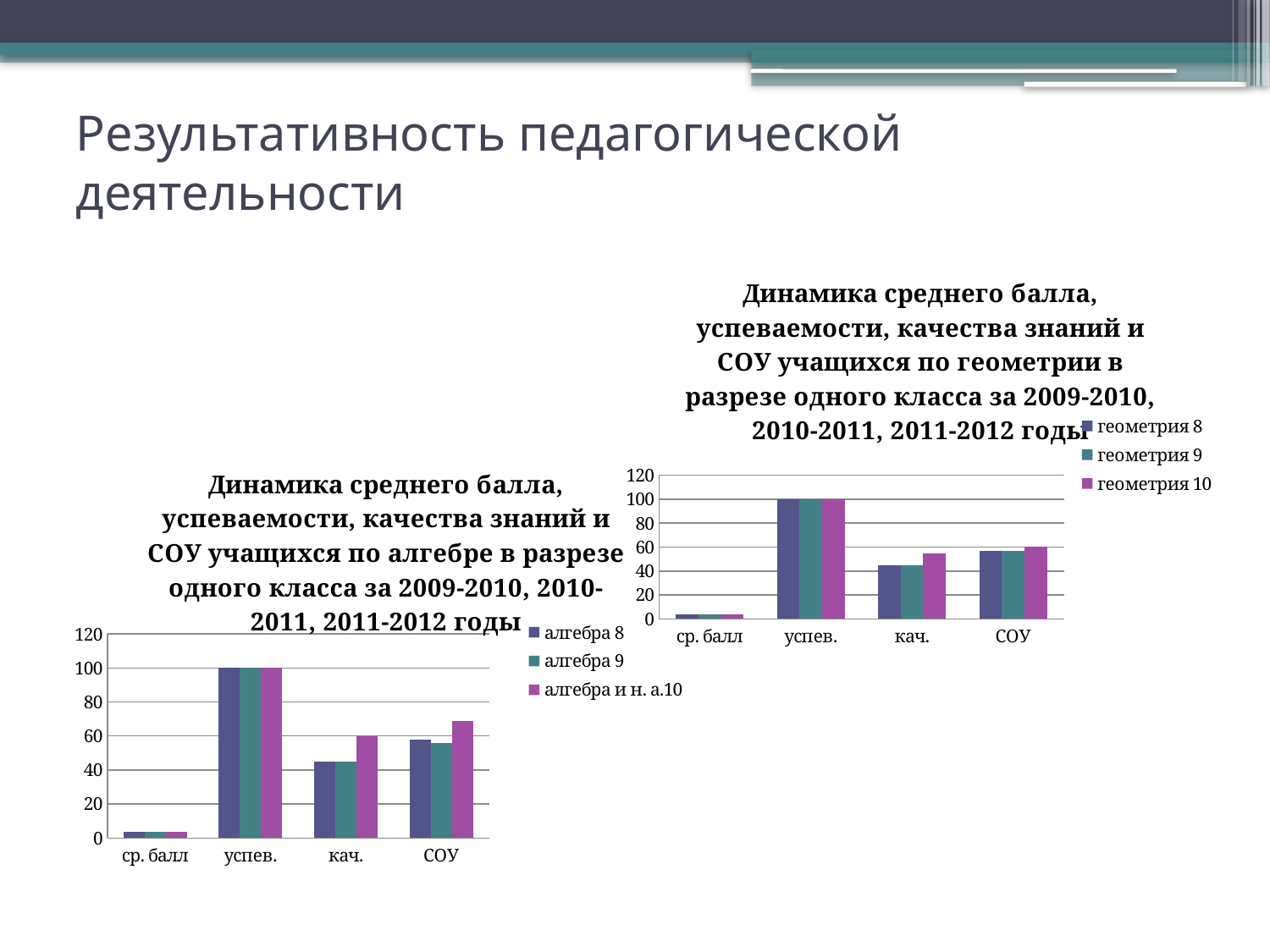
In the right chart about geometry, what is the value for успев. for the series геометрия 10? 100 How many series does the legend of the left chart about algebra list? 3 How many categories are shown on the x axis of the right chart about geometry? 4 In the right chart about geometry, which category has the lowest values? ср. балл In the left chart about algebra, which category has the highest values? успев. In the left chart about algebra, is the value for кач. for the series алгебра 8 greater or less than 60? less What kind of chart is the left chart about algebra? bar chart In the right chart about geometry, is the value for ср. балл for the series геометрия 9 greater or less than 20? less In the left chart about algebra, which is larger for кач.: the value for алгебра 8 or the value for алгебра и н. а.10? алгебра и н. а.10 What are the legend entries of the right chart about geometry? геометрия 8, геометрия 9, геометрия 10 In the left chart about algebra, is the value for СОУ for the series алгебра и н. а.10 greater or less than 60? greater In the left chart about algebra, what is the value for успев. for the series алгебра 8? 100